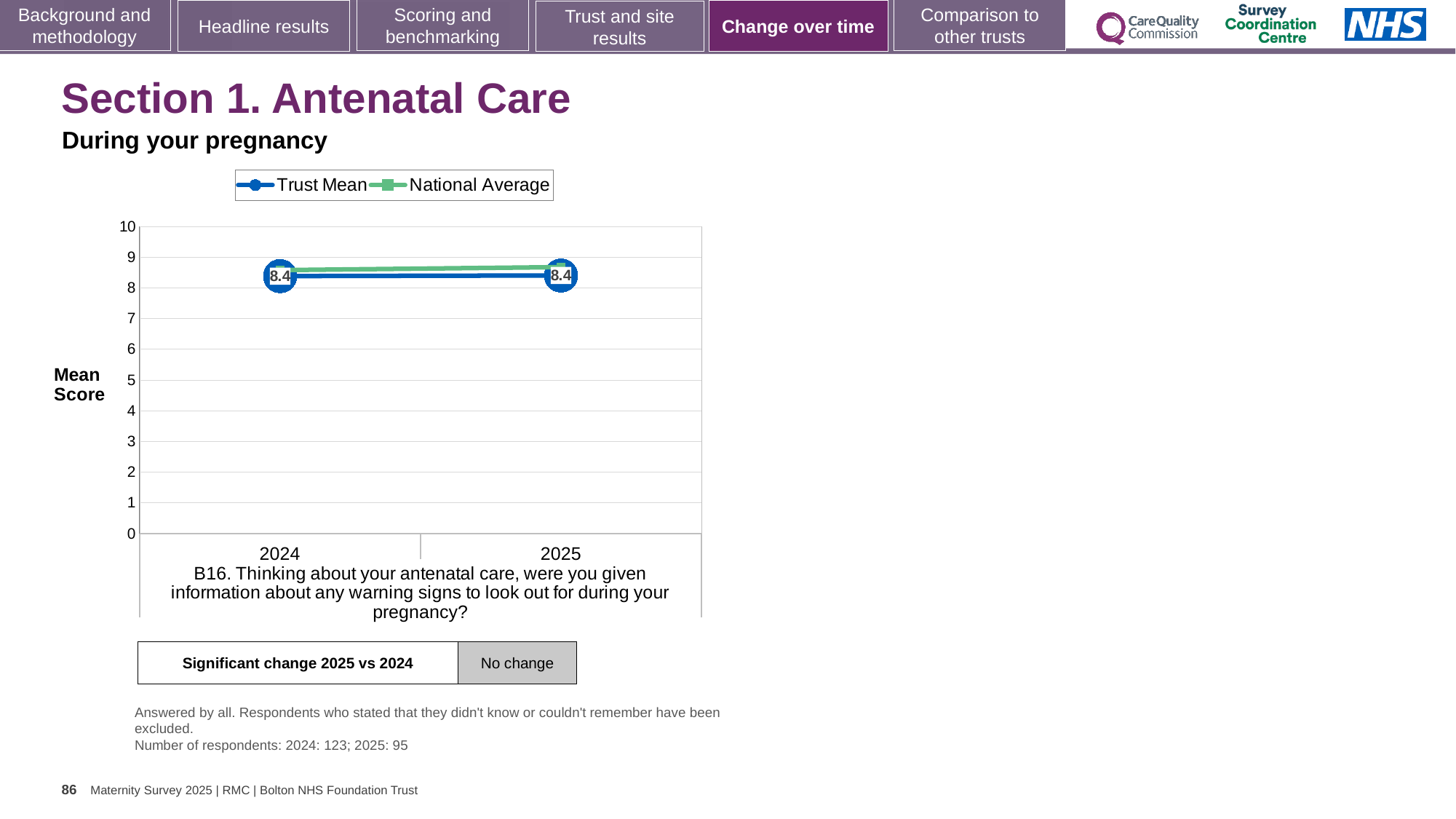
Is the National Average value for 2025 greater or less than 8? greater What is the difference between the Trust Mean scores for 2025 and 2024? 0 What kind of chart is shown on the slide? Line chart Is the Trust Mean for 2024 greater or less than 5? greater What is the Trust Mean score for 2024? 8.4 What is the label on the vertical axis of the chart? Mean Score Is the National Average value for 2024 greater or less than 9? less In 2025, which is higher: the Trust Mean or the National Average? National Average How many years are plotted on the x axis of the chart? 2 Does the Trust Mean rise, fall or stay the same from 2024 to 2025? Stays the same What is the Trust Mean score for 2025? 8.4 How many series does the chart legend list? 2